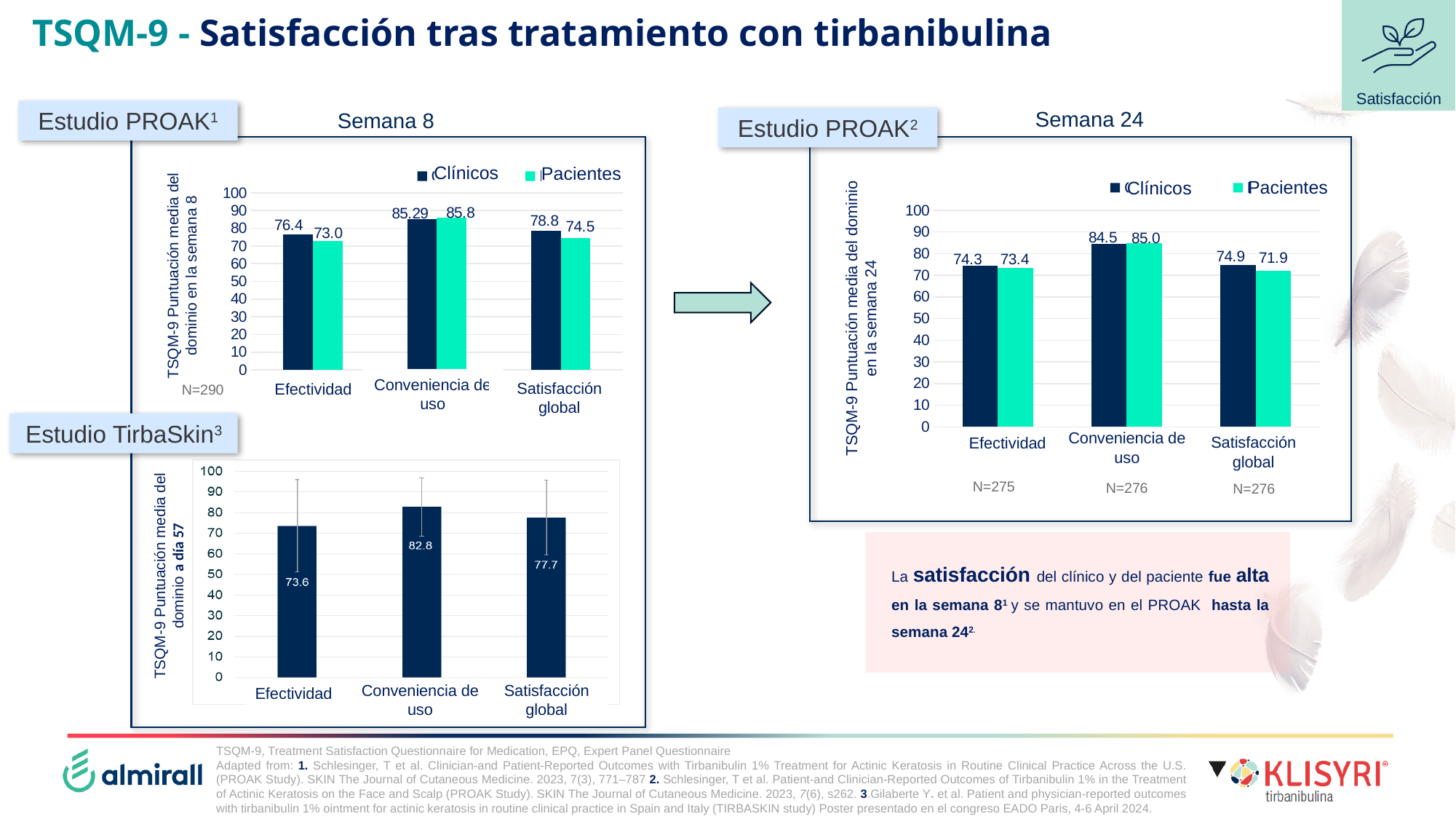
In the Semana 24 chart, which colour represents Pacientes? Green In the Semana 8 chart, what is the value for Pacientes in Conveniencia de uso? 85.8 In the Semana 24 chart, which category has the highest value for Clínicos? Conveniencia de uso In the Semana 8 chart, what is the value for Clínicos in Efectividad? 76.4 What kind of chart is the Semana 24 chart? Bar chart In the Semana 24 chart, what is the value for Pacientes in Satisfacción global? 71.9 In the Semana 24 chart, which is larger in Efectividad: Clínicos or Pacientes? Clínicos In the Estudio TirbaSkin chart, which category has the lowest value? Efectividad How many categories are shown on the x axis of the Estudio TirbaSkin chart? 3 In the Estudio TirbaSkin chart, what is the value for Conveniencia de uso? 82.8 How many series does the legend of the Semana 8 chart list? 2 In the Semana 8 chart, what is the difference between Clínicos and Pacientes in Satisfacción global? 4.3